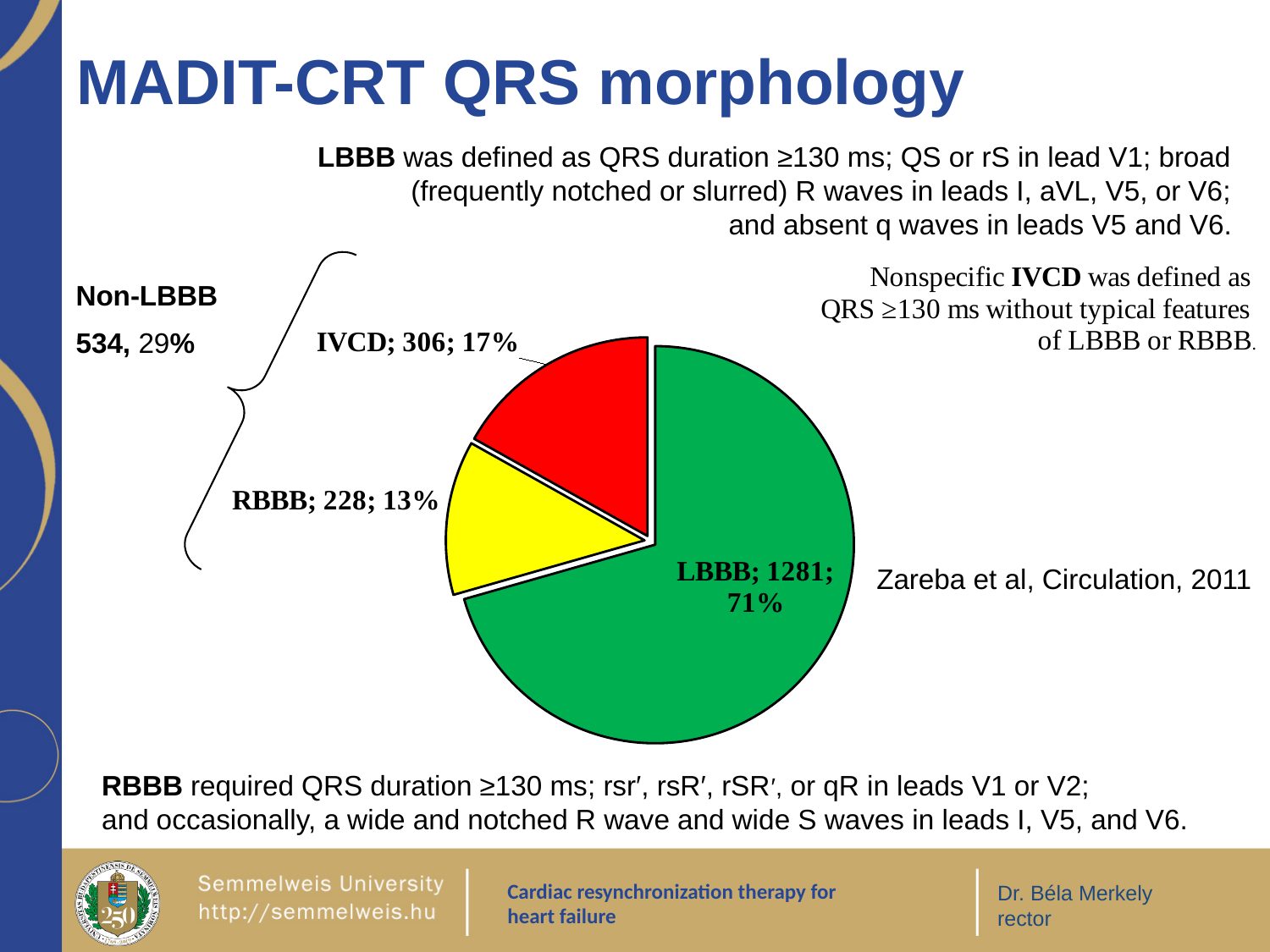
Which slice has more patients, IVCD or RBBB? IVCD Which slice of the pie chart is the smallest? RBBB What percentage share does the RBBB slice have? 13% How many patients are in the RBBB slice? 228 What colour is the LBBB slice of the pie chart? green How many slices does the pie chart have? 3 What is the difference in patient count between the IVCD and RBBB slices? 78 Which slice of the pie chart is the largest? LBBB What kind of chart is shown on the slide? pie chart How many patients are in the LBBB slice of the pie chart? 1281 What percentage of the pie does the IVCD slice represent? 17% What is the combined patient count of the IVCD and RBBB slices? 534